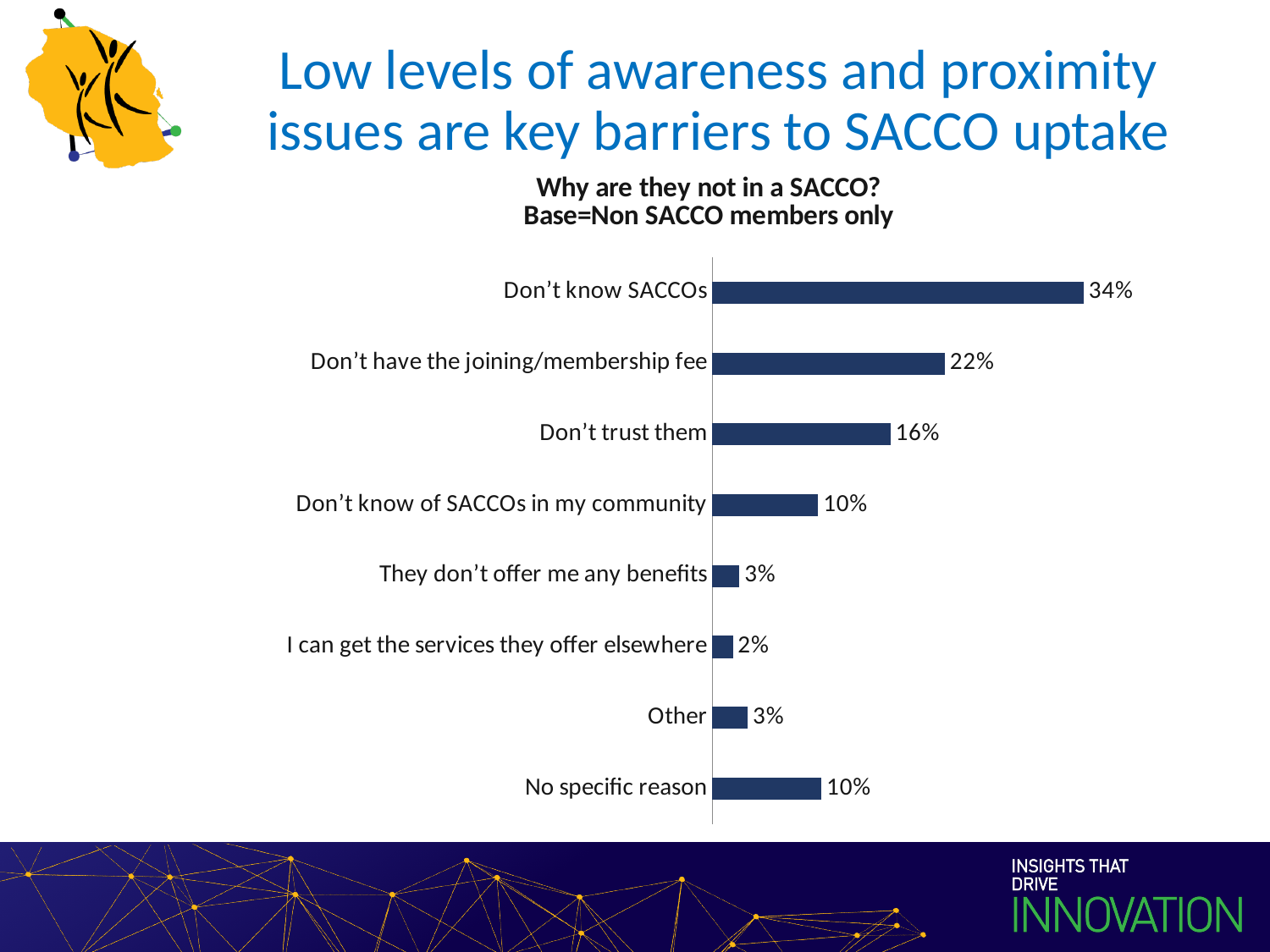
What is the difference between 'Don't know SACCOs' and 'Don't have the joining/membership fee'? 12 percentage points What is the value for 'I can get the services they offer elsewhere'? 2% Which reason has the lowest percentage? I can get the services they offer elsewhere Which is larger: 'Don't trust them' or 'Don't know of SACCOs in my community'? Don't trust them Which reason has the highest percentage? Don't know SACCOs How many reasons (categories) are shown in the chart? 8 What percentage of non-SACCO members say they don't know SACCOs? 34% What is the value for 'Don't have the joining/membership fee'? 22% What is the difference between 'No specific reason' and 'Other'? 7 percentage points What is the base (population) for the chart, as stated in its subtitle? Non SACCO members only What percentage cite 'Don't trust them' as a reason? 16% What type of chart is shown on the slide? Bar chart